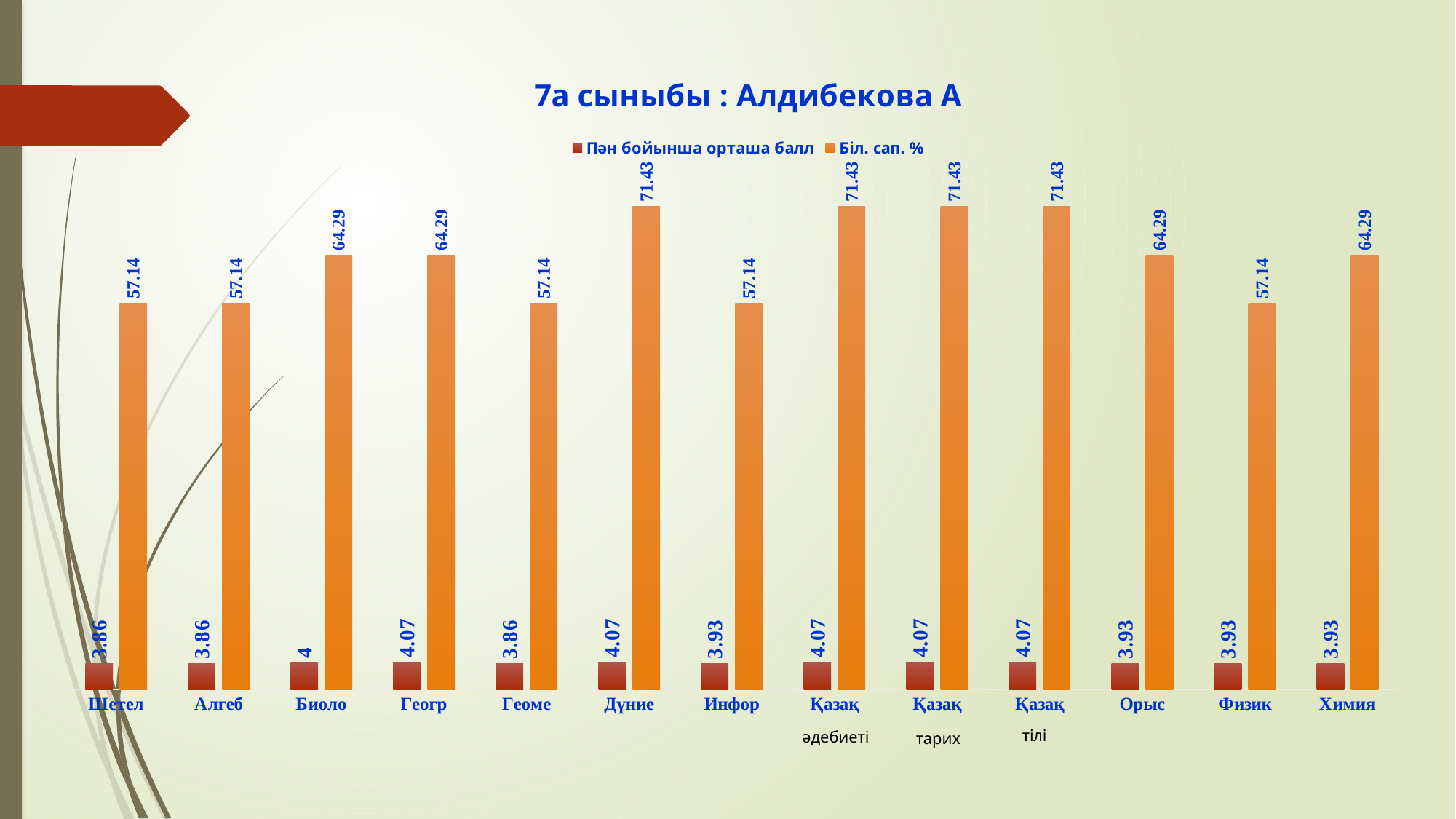
What is the Пән бойынша орташа балл value for Химия? 3.93 What kind of chart is shown on the slide? bar chart What is the Біл. сап. % value for Орыс? 64.29 How many subject categories are shown on the x axis? 13 What is the highest Біл. сап. % value shown on the chart? 71.43 What is the difference between the Біл. сап. % values for Дүние and Шетел? 14.29 What is the title of the chart? 7а сыныбы : Алдибекова А What is the lowest Пән бойынша орташа балл value shown on the chart? 3.86 What is the Біл. сап. % value for Дүние? 71.43 Which has a higher Біл. сап. % value, Биоло or Физик? Биоло What is the Пән бойынша орташа балл value for Биоло? 4 How many series does the legend list? 2